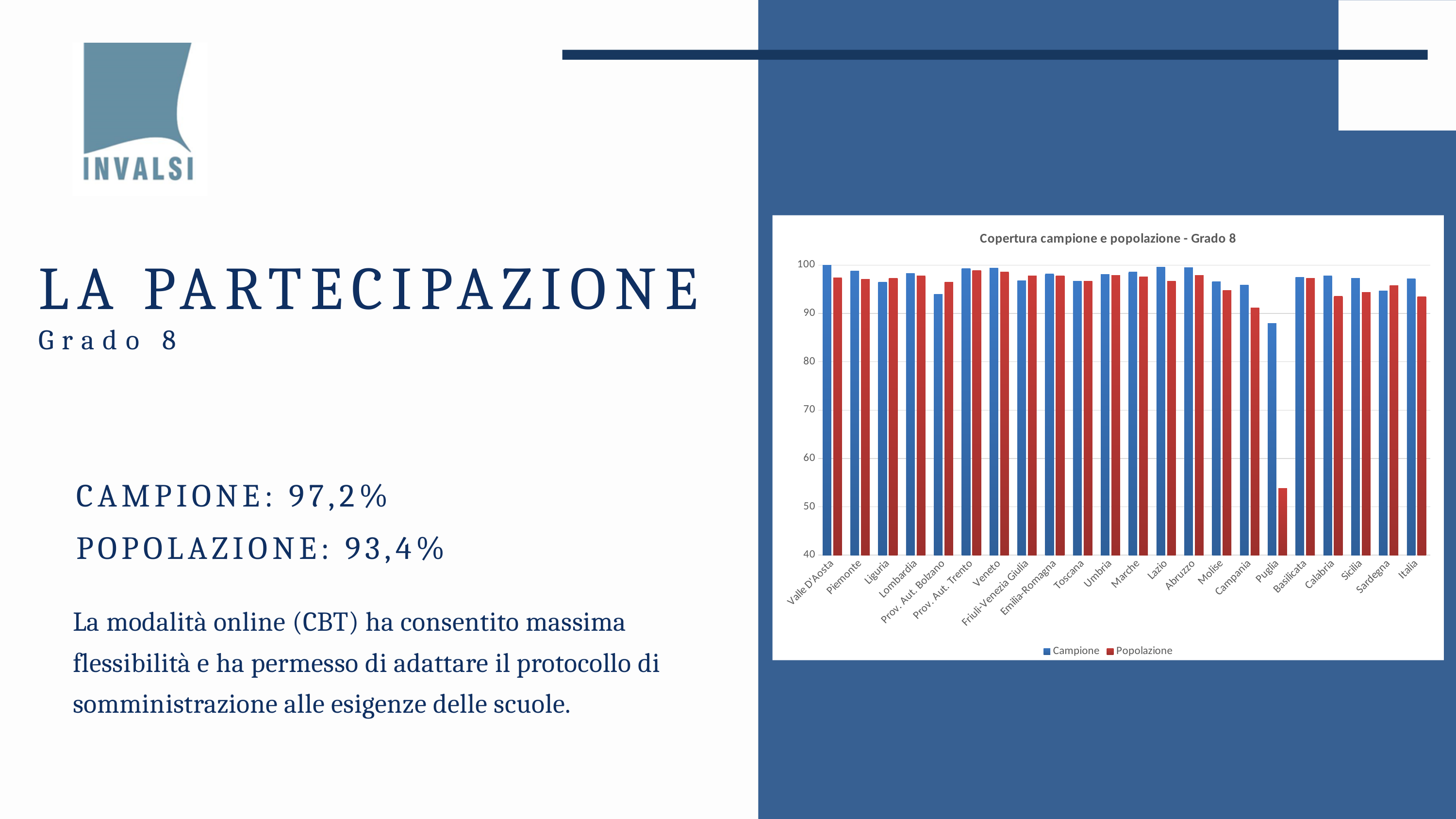
For Puglia, which is larger: the Campione value or the Popolazione value? Campione Which category has the lowest Campione value? Puglia Which is larger: the Campione value for Valle D'Aosta or the Campione value for Puglia? Valle D'Aosta Is the Campione value for Puglia greater or less than 90? less Which series is shown in red in the chart? Popolazione How many series does the chart legend list? 2 What is the title of the chart? Copertura campione e popolazione - Grado 8 Is the Popolazione value for Puglia greater or less than 60? less How many categories are shown on the x axis of the chart? 22 Is the Campione value for Valle D'Aosta greater or less than 90? greater Which category has the lowest Popolazione value? Puglia What kind of chart is shown on the slide? bar chart